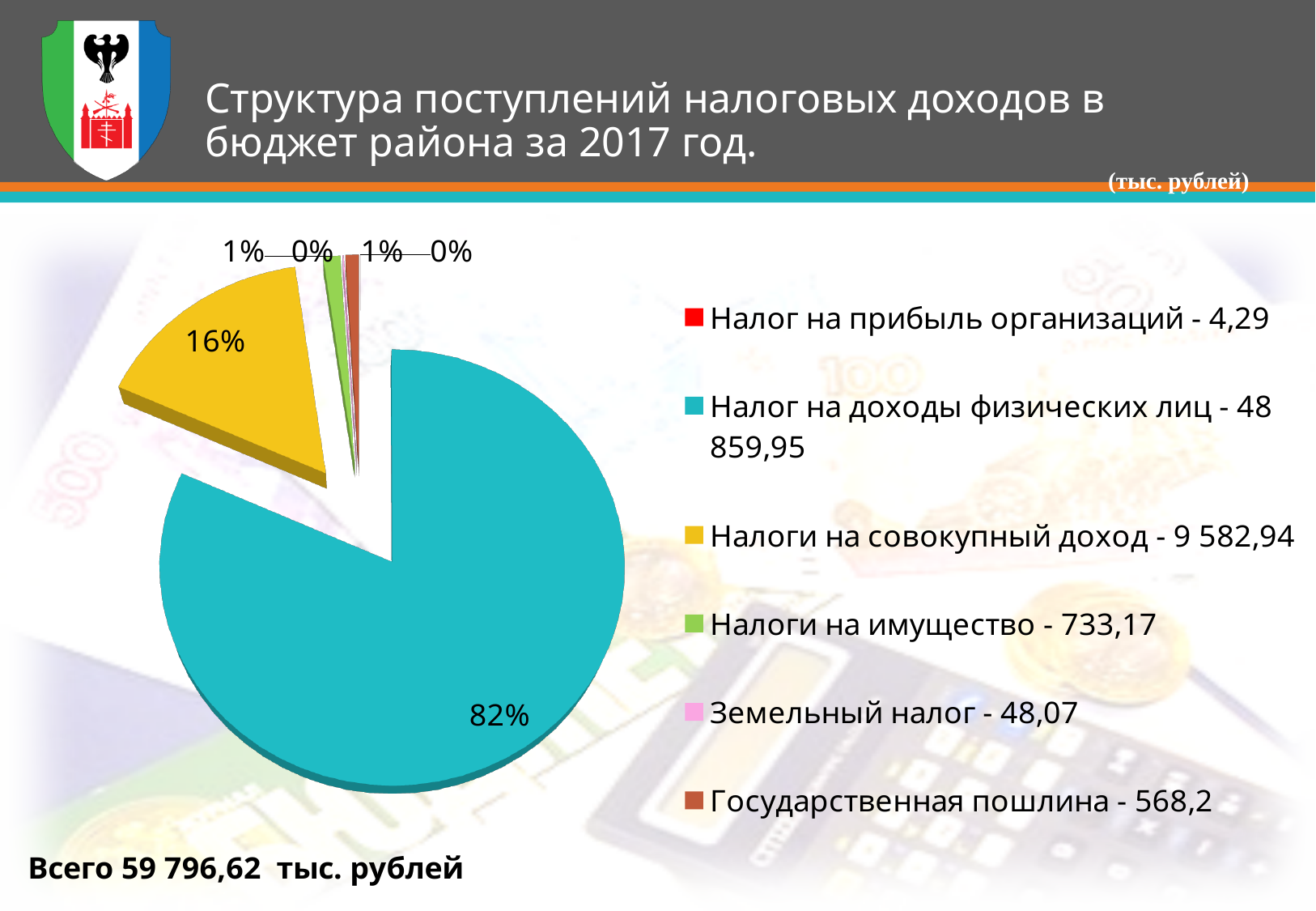
Which is larger, Налоги на имущество or Государственная пошлина? Налоги на имущество What share of the pie does Налоги на совокупный доход take? 16% What share of the pie does Налог на доходы физических лиц take? 82% Which category has the largest share of the pie? Налог на доходы физических лиц What is the difference between Налог на доходы физических лиц and Налоги на совокупный доход? 39 277,01 What is the value for Государственная пошлина? 568,2 What is the value for Налоги на совокупный доход? 9 582,94 How many categories does the pie chart have? 6 Which category has the smallest value? Налог на прибыль организаций What kind of chart is shown on the slide? Pie chart What is the value for Налог на доходы физических лиц? 48 859,95 What is the value for Земельный налог? 48,07